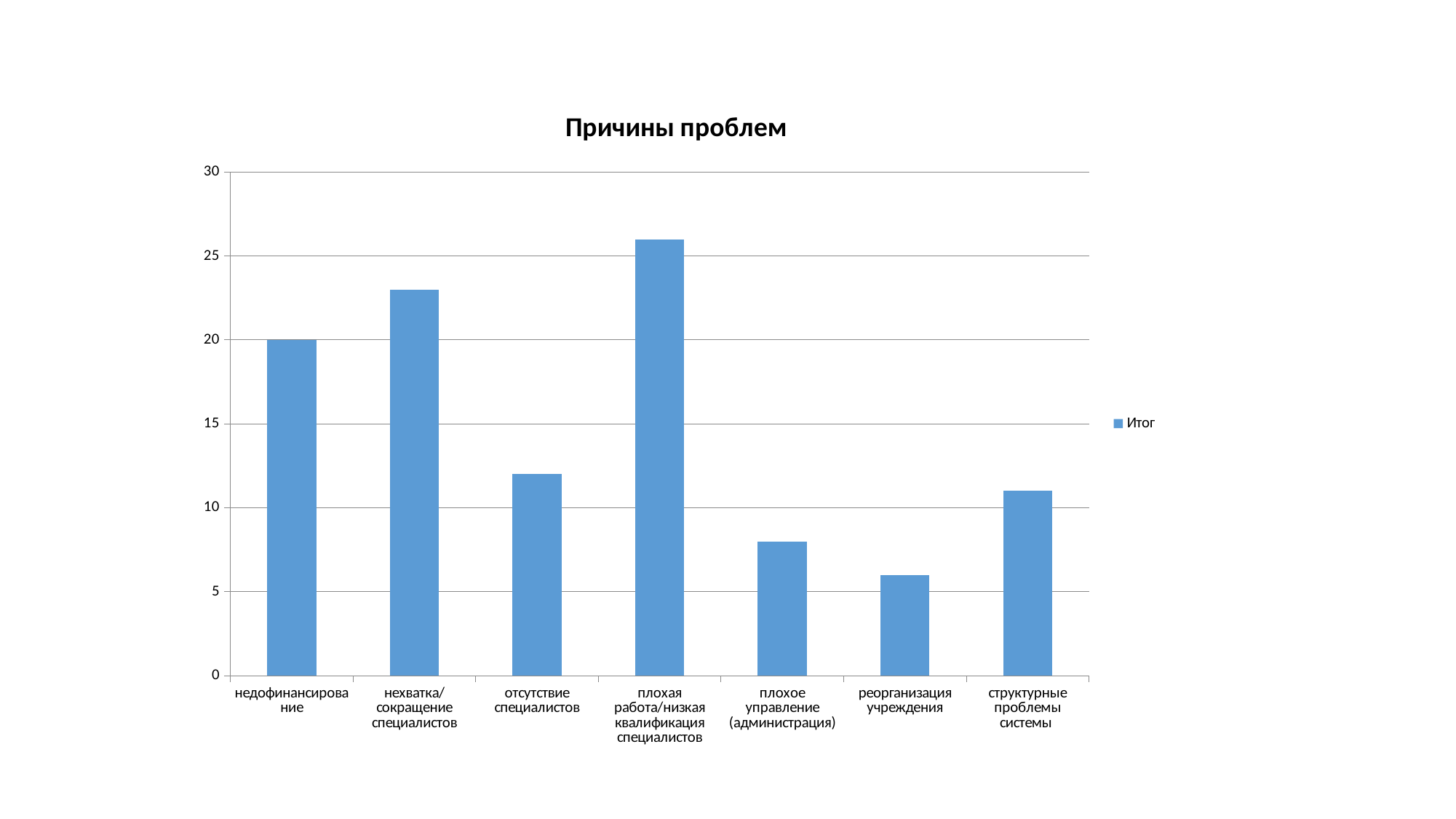
Is the value for нехватка/сокращение специалистов greater or less than 20? greater Which is larger: the value for структурные проблемы системы or the value for реорганизация учреждения? структурные проблемы системы What type of chart is shown on the slide? bar chart Is the value for отсутствие специалистов greater or less than 15? less Is the value for плохое управление (администрация) greater or less than 10? less How many series does the legend list? 1 Which category has the highest value? плохая работа/низкая квалификация специалистов What is the value for недофинансирование? 20 What is the title of the chart? Причины проблем Which category has the lowest value? реорганизация учреждения What is the name of the series shown in the legend? Итог How many categories are shown on the x axis? 7